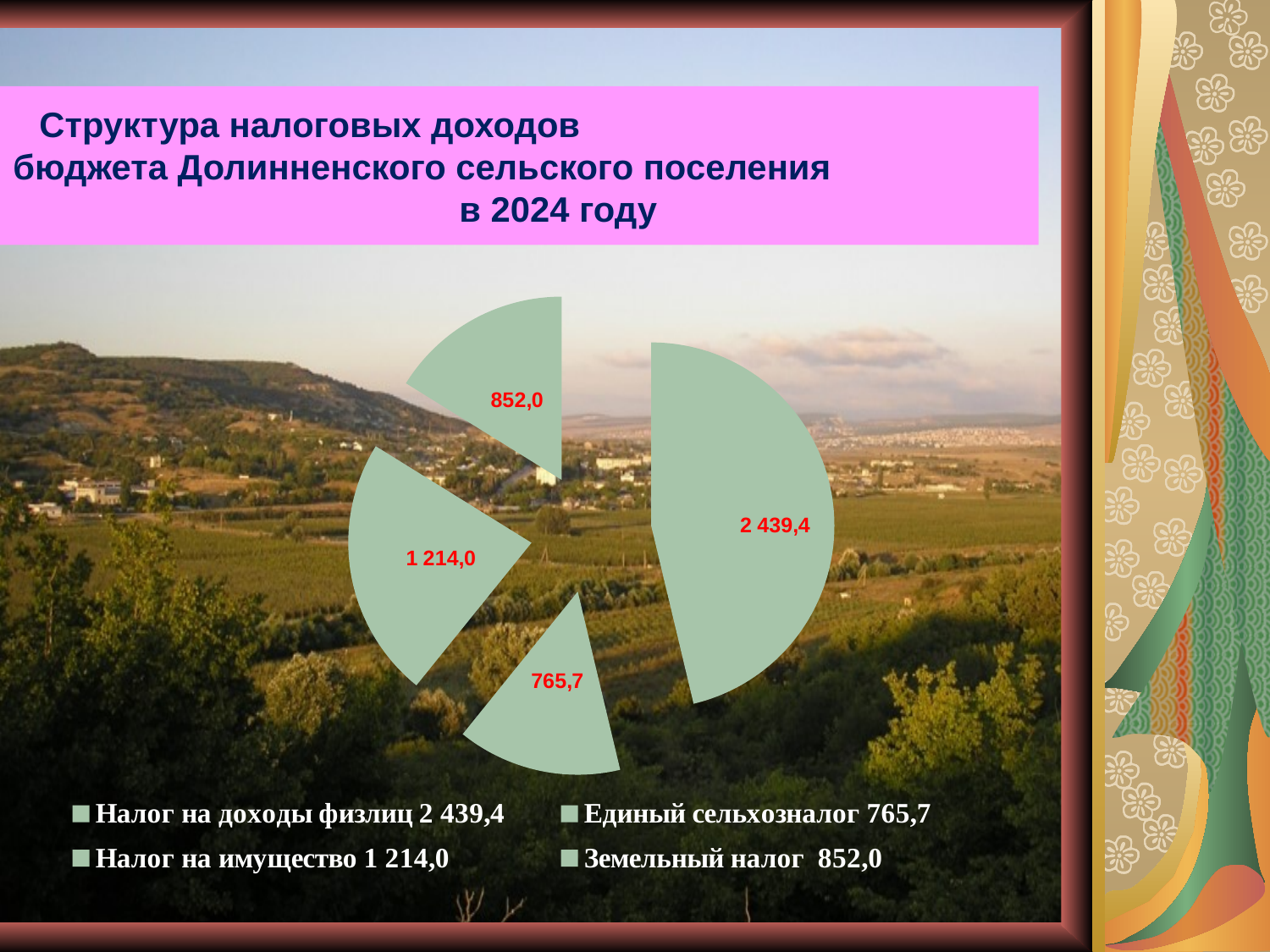
What is the difference between Налог на доходы физлиц and Налог на имущество? 1 225,4 What is the difference between Земельный налог and Единый сельхозналог? 86,3 What is the value for Налог на доходы физлиц? 2 439,4 Which category has the largest slice of the pie? Налог на доходы физлиц What kind of chart is shown on the slide? pie chart What is the value for Налог на имущество? 1 214,0 What is the total of all the slices in the pie chart? 5 271,1 Which is larger, Земельный налог or Единый сельхозналог? Земельный налог What is the value for Единый сельхозналог? 765,7 How many slices does the pie chart have? 4 Which category has the smallest slice of the pie? Единый сельхозналог What is the value for Земельный налог? 852,0